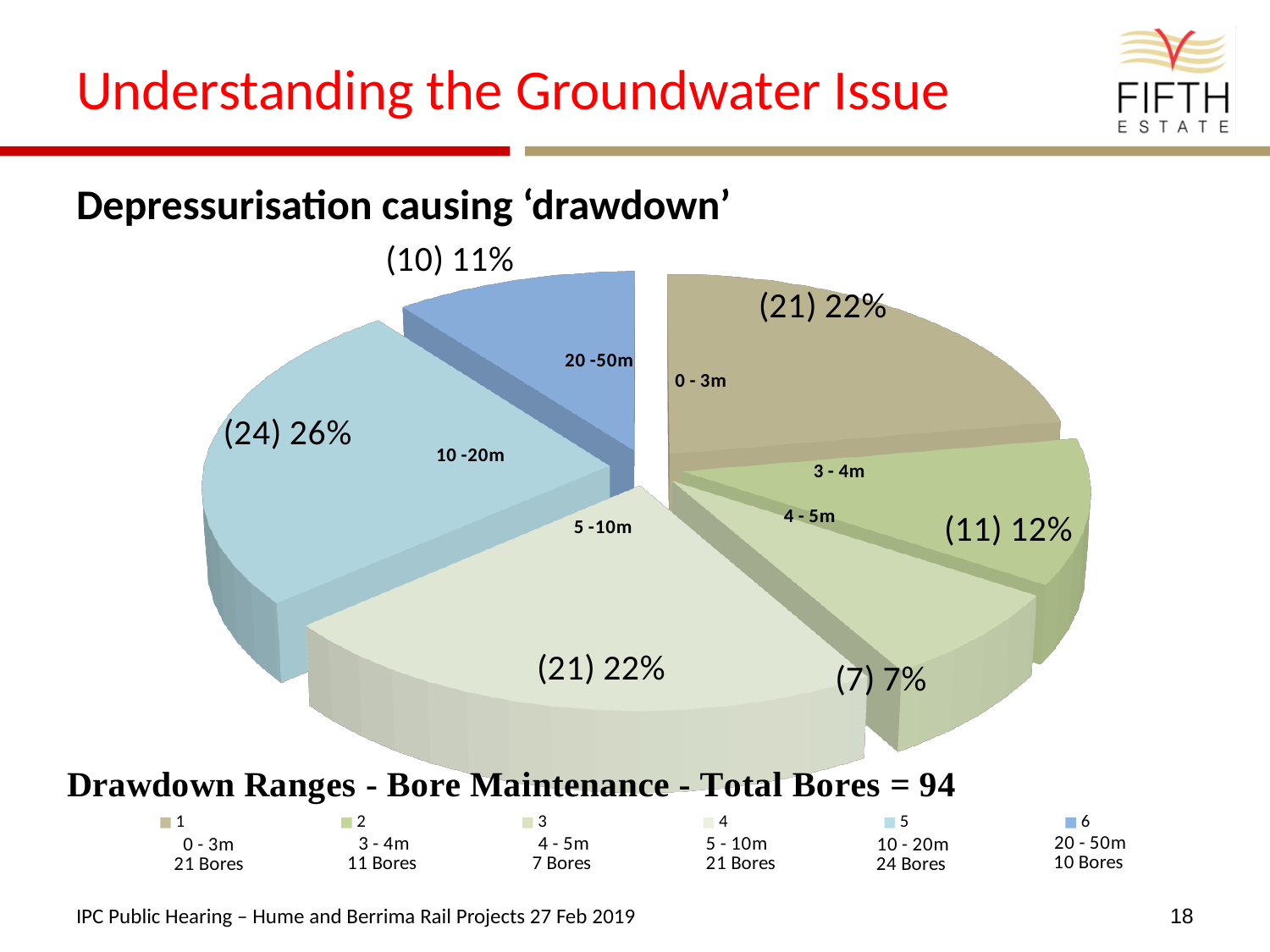
What percentage share does the 20 -50m slice have? 11% What type of chart is shown on the slide? pie chart Which drawdown range has the smallest share of the pie? 4 - 5m What percentage share does the 10 -20m slice have? 26% Which drawdown range has the largest share of the pie? 10 -20m What is the difference in number of bores between the 10 -20m range and the 20 -50m range? 14 How many bores are in the 4 - 5m drawdown range? 7 What is the total number of bores stated in the chart title? 94 How many slices does the pie chart have? 6 What is the title of the chart? Drawdown Ranges - Bore Maintenance - Total Bores = 94 Which has more bores, the 3 - 4m range or the 4 - 5m range? 3 - 4m How many bores are in the 0 - 3m drawdown range? 21